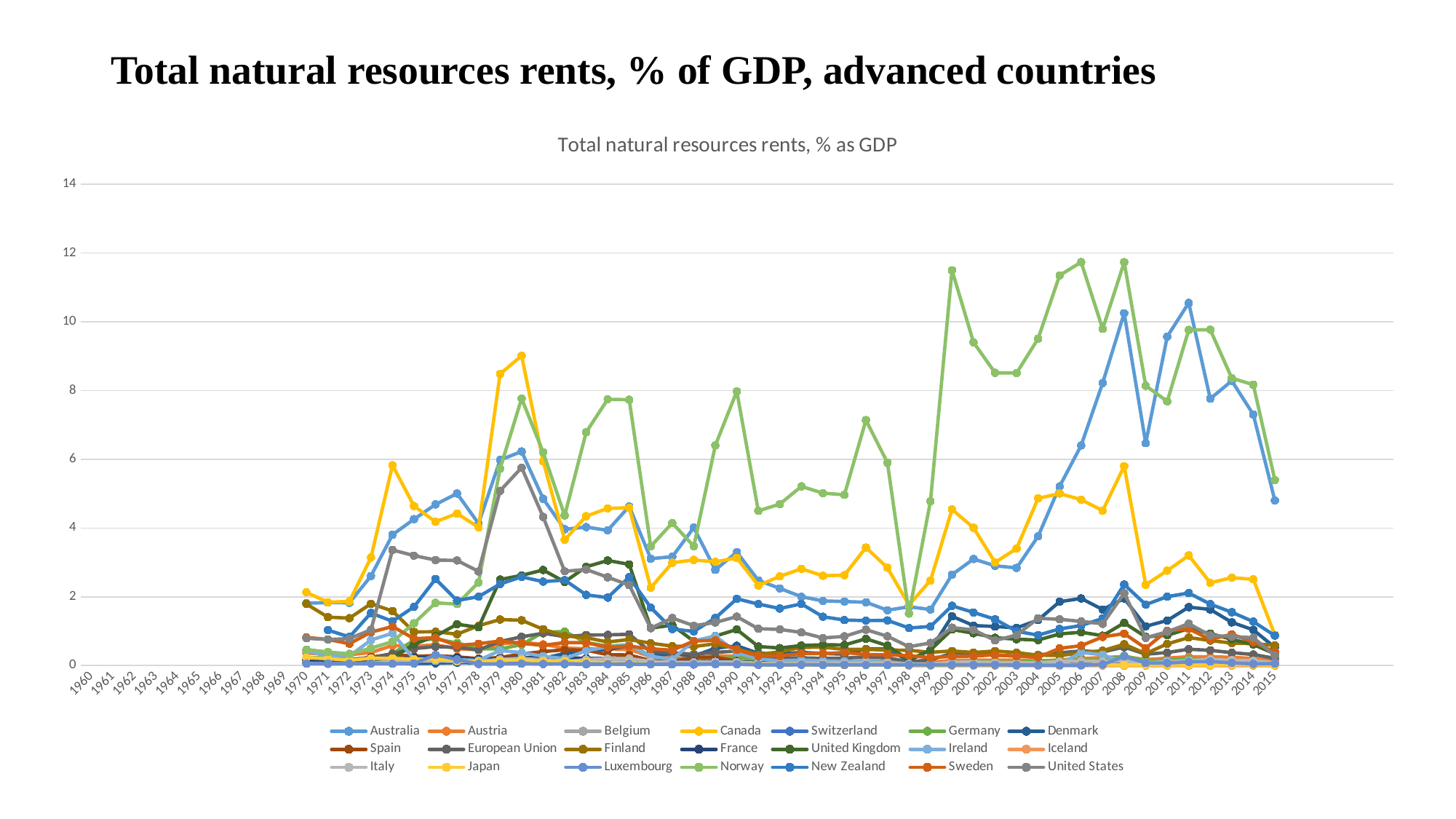
Is the value for Australia in 2009 greater or less than 8? less How many series does the legend list? 21 What kind of chart is shown on the slide? line chart In 2011, which is higher, Australia or Canada? Australia Is the value for Canada in 1980 greater or less than 8? greater What is the highest value shown on the vertical axis? 14 In 1980, which is higher, Canada or Australia? Canada What is the title printed inside the chart area? Total natural resources rents, % as GDP Is the value for Canada in 2015 greater or less than 2? less Does the value for Australia rise or fall from 2011 to 2015? fall